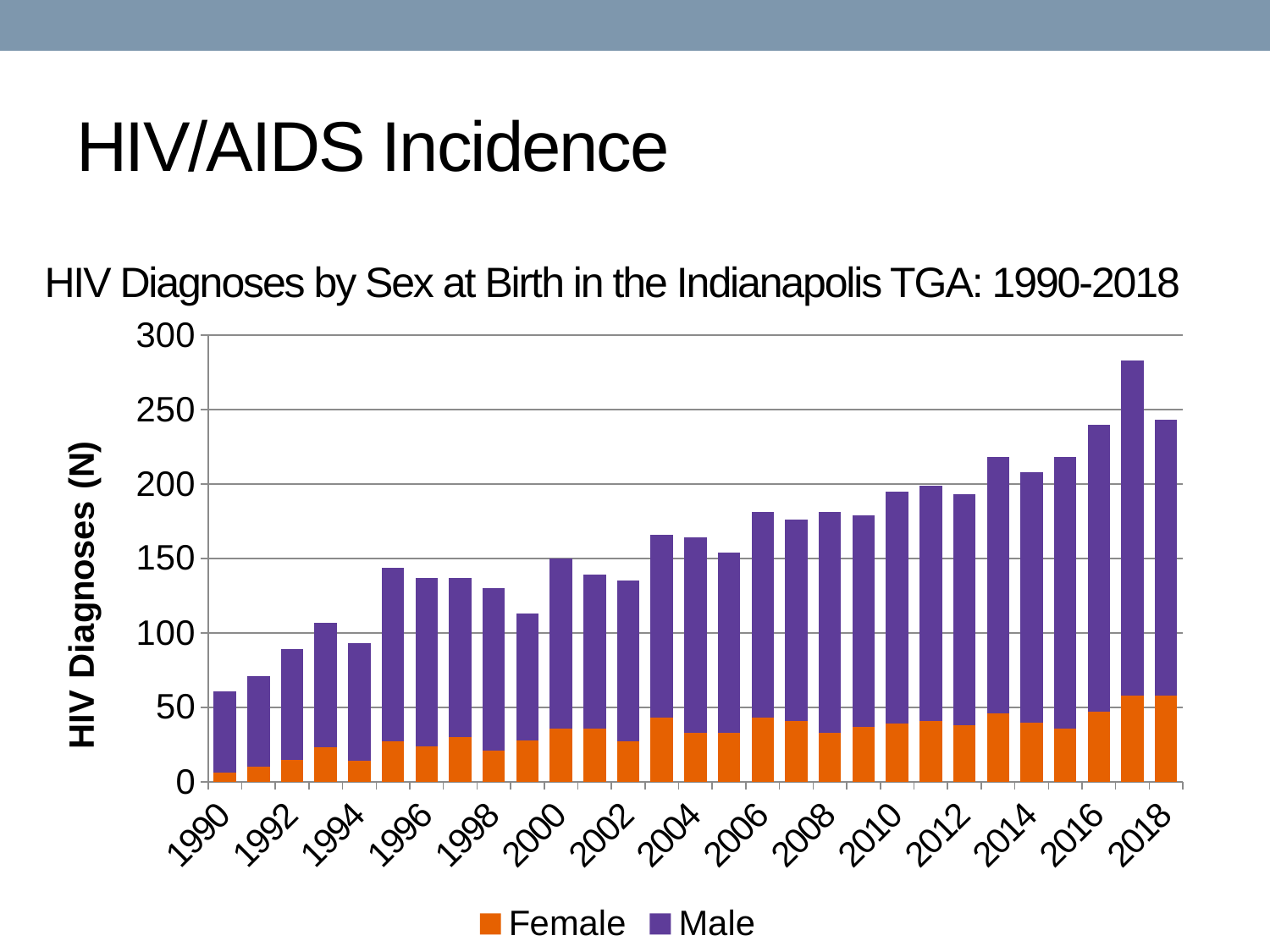
Is the total number of HIV diagnoses in 1994 greater or less than 100? less Which year has a higher total of HIV diagnoses, 2017 or 2018? 2017 Overall, do total HIV diagnoses rise or fall from 1990 to 2018? rise Is the total number of HIV diagnoses in 2017 greater or less than 250? greater Which colour represents the Female series in the chart? Orange Which year has the highest total number of HIV diagnoses? 2017 What is the title of the chart? HIV Diagnoses by Sex at Birth in the Indianapolis TGA: 1990-2018 How many series does the legend list? 2 What kind of chart is shown on the slide? Stacked bar chart Is the total number of HIV diagnoses in 2018 greater or less than 200? greater Which year has the lowest total number of HIV diagnoses? 1990